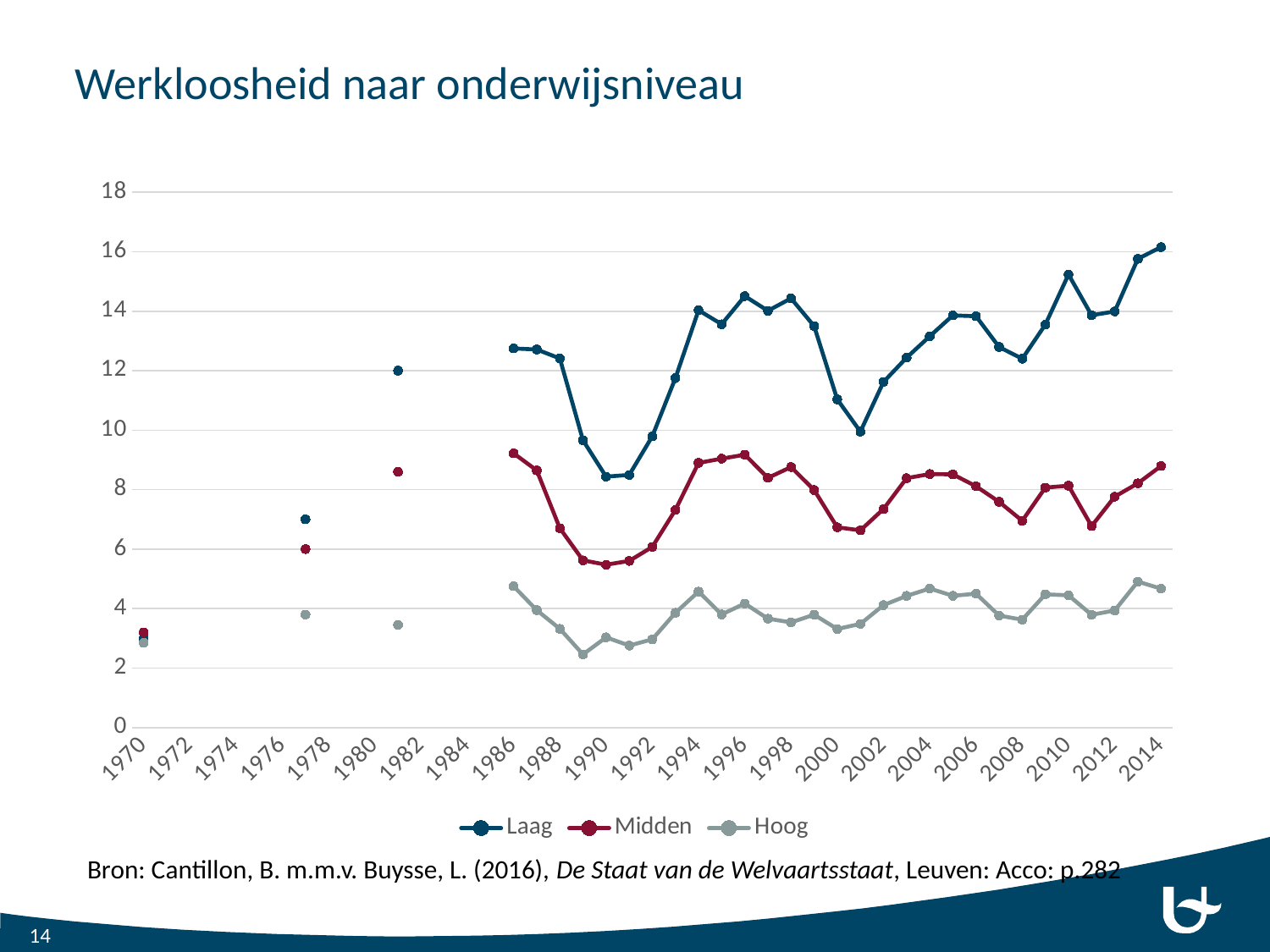
What is the title of the chart? Werkloosheid naar onderwijsniveau What kind of chart is shown on the slide? line chart What are the names of the series in the legend? Laag, Midden, Hoog How many series does the legend list? 3 Is the value for Laag in 2014 greater or less than 14? greater Does the Laag series rise or fall between 1988 and 1990? fall Which series has the highest values across the chart? Laag Is the value for Midden in 1990 greater or less than 6? less In 2014, which is larger, the value for Laag or the value for Midden? Laag Is the value for Laag in 2002 greater or less than 12? less Which series has the lowest values across the chart? Hoog